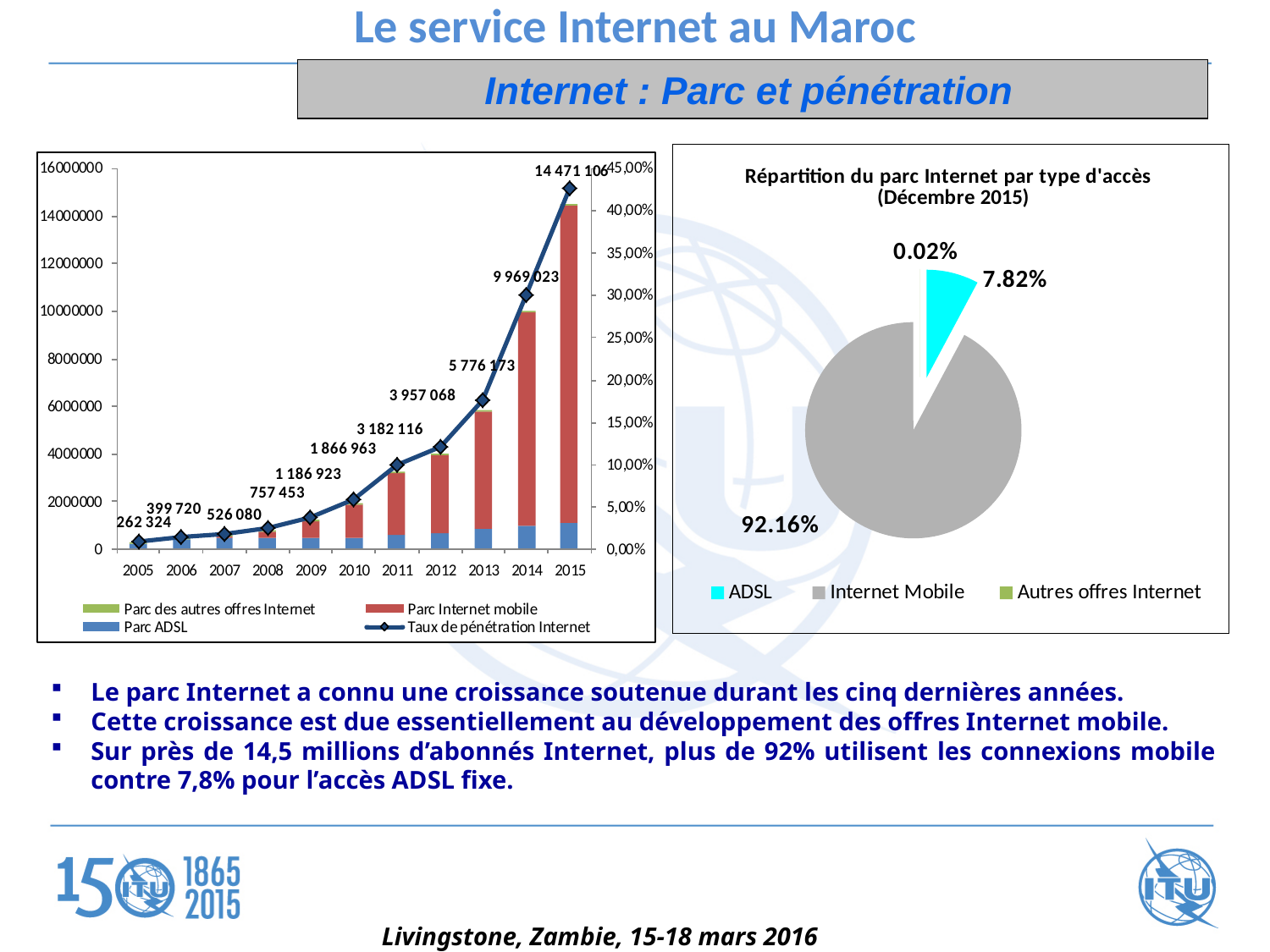
What kind of chart is the 'Répartition du parc Internet par type d'accès (Décembre 2015)' chart? pie chart In the left chart, what value is labelled for 2010? 1 866 963 In the 'Répartition du parc Internet par type d'accès' chart, what share does Internet Mobile have? 92.16% In the left chart, how many series does the legend list? 4 In the left chart, what is the difference between the labelled values for 2015 and 2014? 4 502 083 In the left chart, which year has the highest labelled value? 2015 In the left chart, how many years are shown on the x axis? 11 In the left chart, is the Taux de pénétration Internet for 2015 greater or less than 40,00%? greater In the left chart, which year has the lowest labelled value? 2005 In the 'Répartition du parc Internet par type d'accès' chart, which type of access has the largest slice? Internet Mobile In the left chart, what value is labelled for 2015? 14 471 106 In the left chart, do the labelled values rise or fall from 2005 to 2015? rise